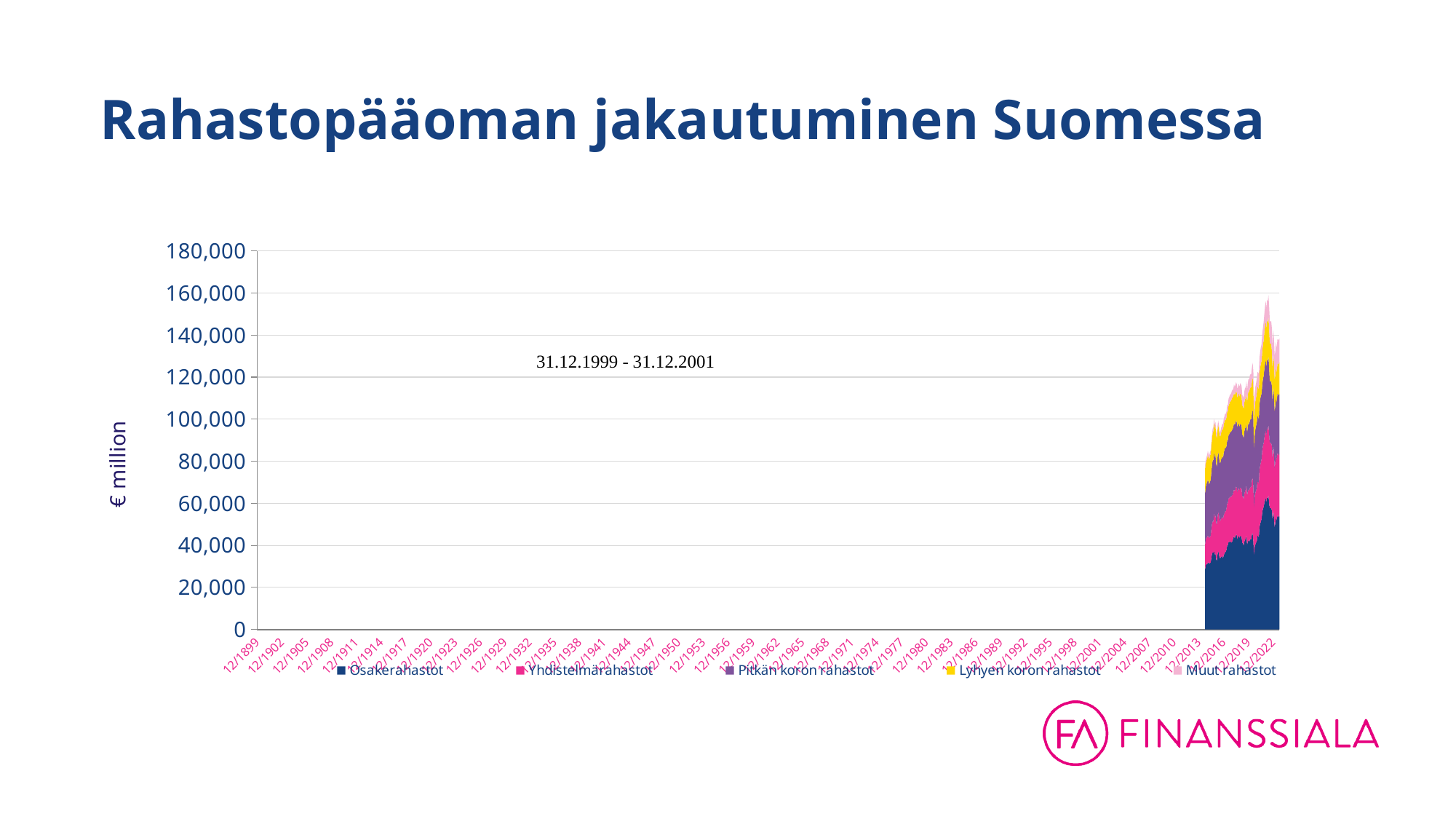
What unit is shown on the vertical axis label? € million Is the value for Osakerahastot at the right end of the chart greater or less than 80,000? less Is the highest point of the total stacked value greater or less than 180,000? less How many series does the legend list? 5 Is the value for Osakerahastot at the right end of the chart greater or less than 40,000? greater What kind of chart is shown on the slide? Stacked area chart What is the title of the chart on the slide? Rahastopääoman jakautuminen Suomessa Do the total stacked values generally rise or fall from 12/2013 to 12/2022? rise Which series is plotted at the bottom of the stack? Osakerahastot